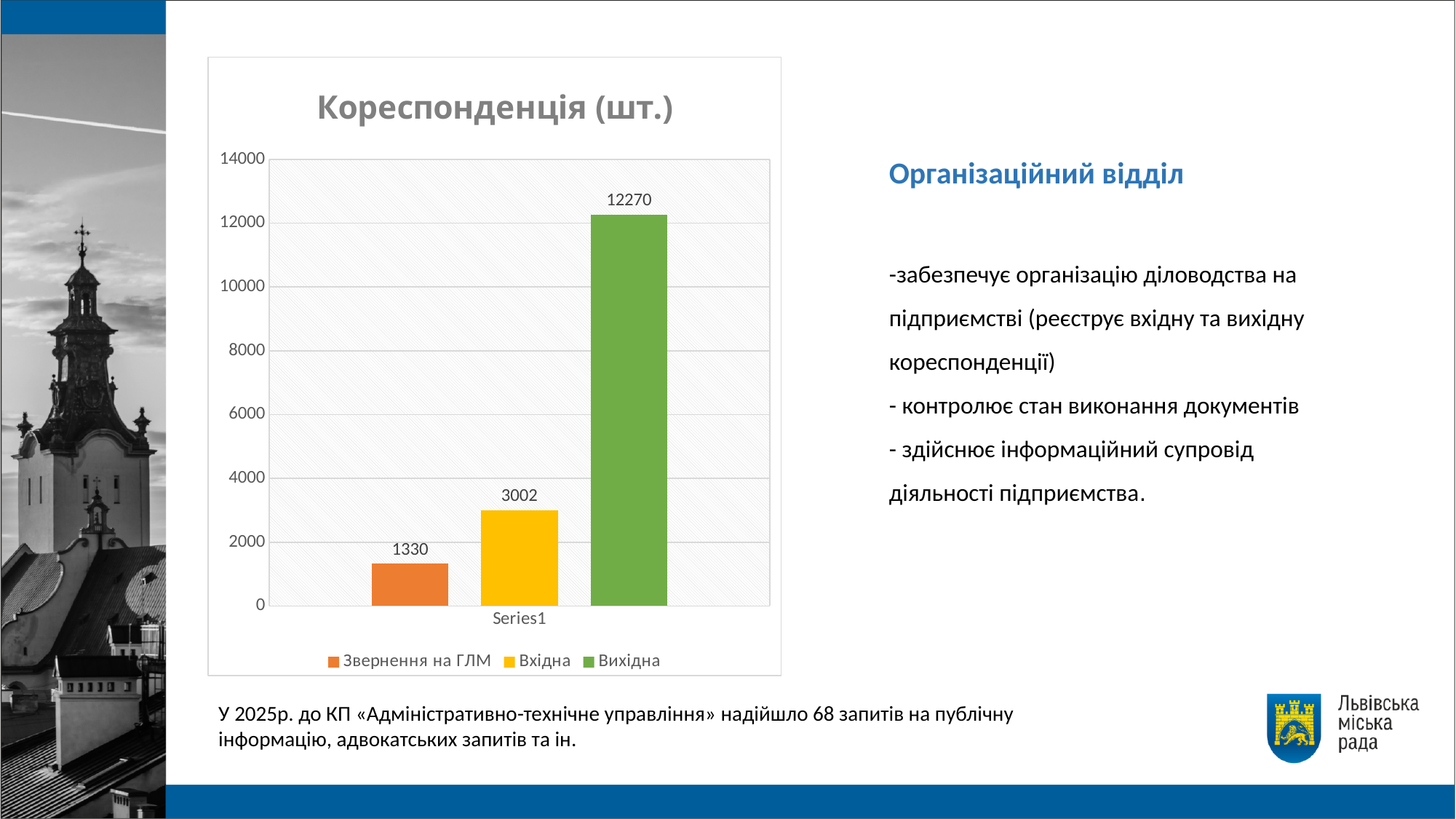
What is the difference between the values for Вхідна and Звернення на ГЛМ? 1672 How many series does the legend list? 3 What is the value for Звернення на ГЛМ in the chart? 1330 Which is larger, the value for Вхідна or the value for Звернення на ГЛМ? Вхідна Which series has the lowest value in the chart? Звернення на ГЛМ What is the title of the chart? Кореспонденція (шт.) What is the difference between the values for Вихідна and Вхідна? 9268 Which series has the highest value in the chart? Вихідна Is the value for Вихідна greater or less than 10000? greater What kind of chart is shown on the slide? bar chart What is the value for Вихідна in the chart? 12270 What is the value for Вхідна in the chart? 3002